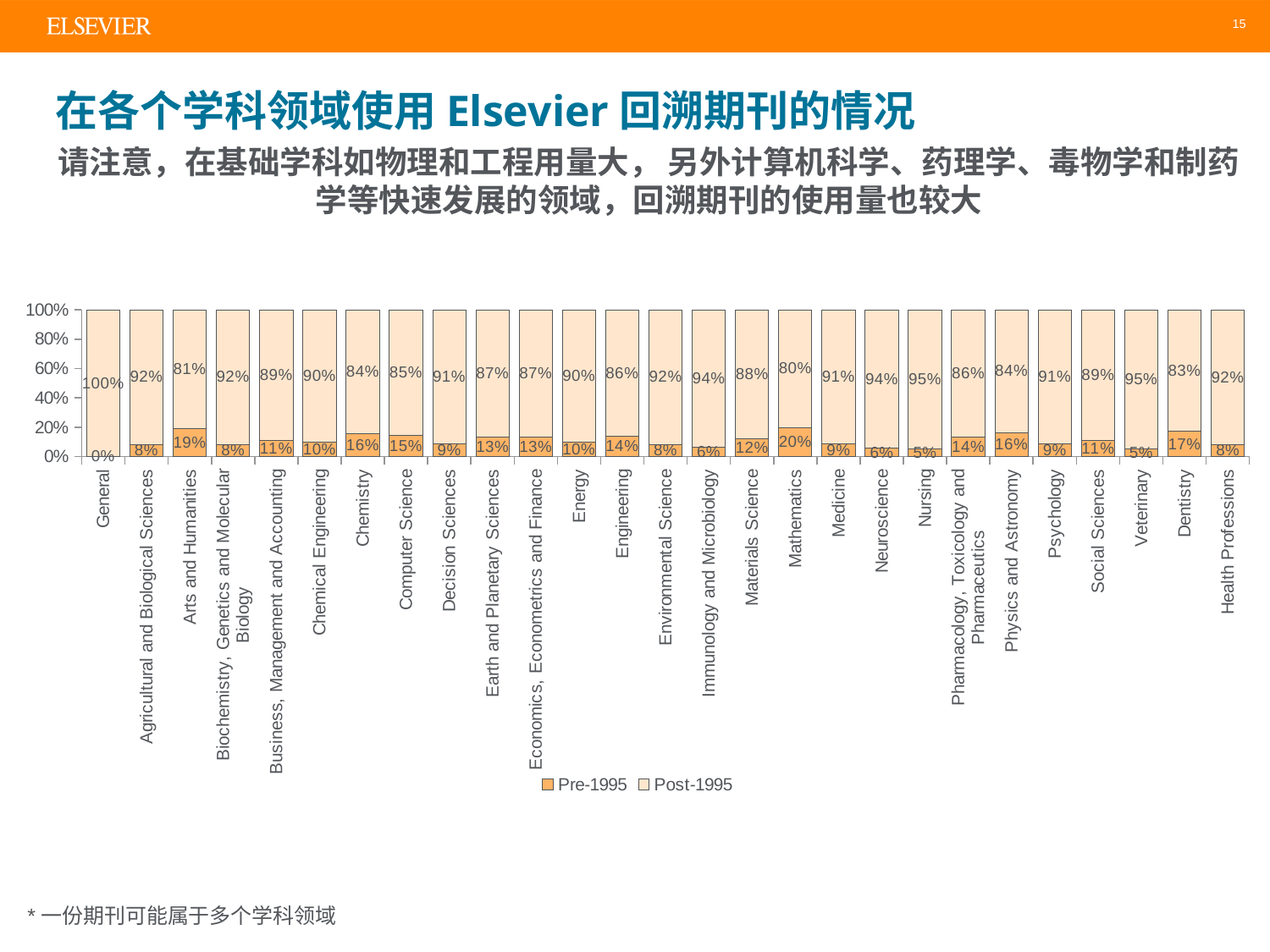
What is the Pre-1995 value for Computer Science? 15% What is the Post-1995 value for Arts and Humanities? 81% How many categories are shown on the x axis? 27 What is the Pre-1995 value for Mathematics? 20% Which has a larger Pre-1995 value, Physics and Astronomy or Medicine? Physics and Astronomy Which category has the lowest Post-1995 value? Mathematics How many series does the legend list? 2 Which category has the highest Pre-1995 value? Mathematics What is the Post-1995 value for Nursing? 95% What kind of chart is this? Stacked bar chart What is the difference between the Pre-1995 values for Dentistry and Veterinary? 12% What is the total of the stacked bar for Engineering? 100%